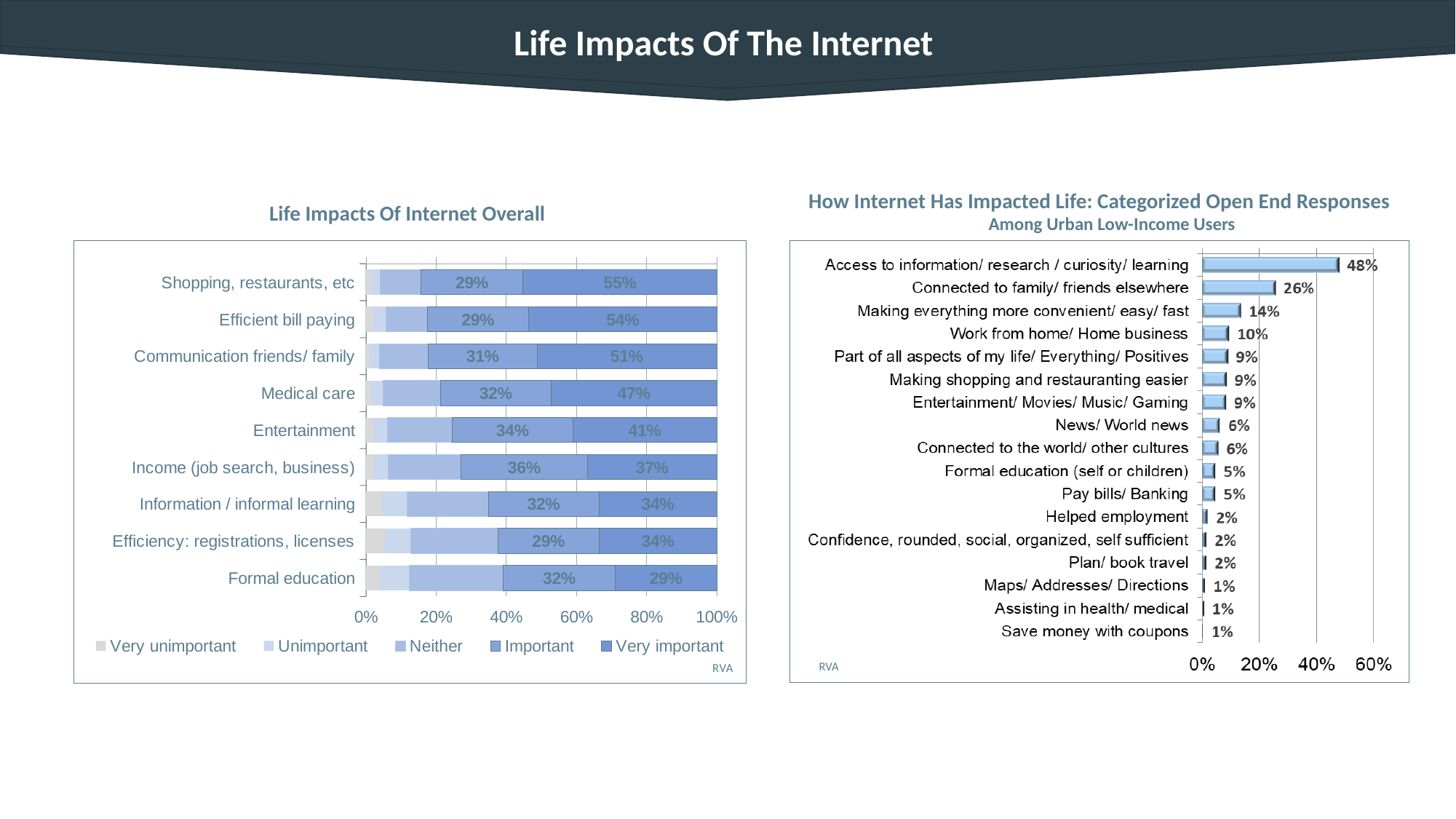
In the 'How Internet Has Impacted Life' chart, what is the value for Connected to family/ friends elsewhere? 26% In the 'How Internet Has Impacted Life' chart, which is larger: Work from home/ Home business or News/ World news? Work from home/ Home business What kind of chart is the 'How Internet Has Impacted Life' chart? Bar chart In the 'Life Impacts Of Internet Overall' chart, which category has the lowest 'Very important' value? Formal education In the 'Life Impacts Of Internet Overall' chart, how many series does the legend list? 5 In the 'Life Impacts Of Internet Overall' chart, what is the 'Important' value for Entertainment? 34% In the 'How Internet Has Impacted Life' chart, what is the difference between Access to information/ research / curiosity/ learning and Making everything more convenient/ easy/ fast? 34% In the 'How Internet Has Impacted Life' chart, which category has the highest value? Access to information/ research / curiosity/ learning In the 'Life Impacts Of Internet Overall' chart, what is the 'Very important' value for Shopping, restaurants, etc? 55% In the 'Life Impacts Of Internet Overall' chart, which category has the highest 'Very important' value? Shopping, restaurants, etc In the 'Life Impacts Of Internet Overall' chart, how many categories are shown? 9 In the 'Life Impacts Of Internet Overall' chart, what is the difference between the 'Very important' values for Medical care and Income (job search, business)? 10%